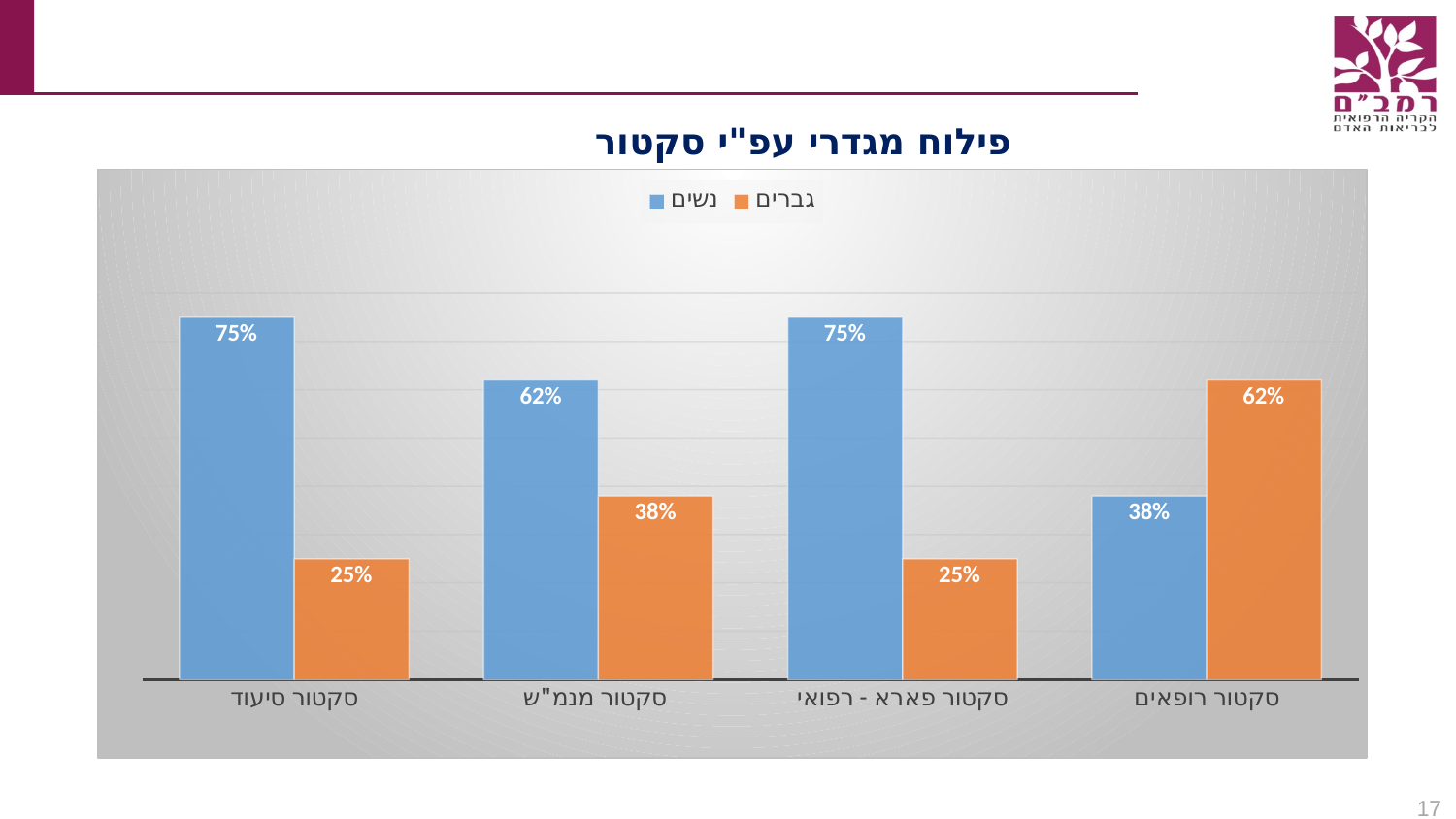
What is the value for נשים in סקטור סיעוד? 75% In which sector is the value for גברים the highest? סקטור רופאים How many series does the legend list? 2 How many sector categories are shown on the x axis? 4 What is the title of the chart? פילוח מגדרי עפ"י סקטור What is the difference between נשים and גברים in סקטור מנמ"ש? 24% Which is larger in סקטור רופאים, the value for נשים or the value for גברים? גברים What is the value for גברים in סקטור רופאים? 62% What is the value for נשים in סקטור פארא - רפואי? 75% What is the value for גברים in סקטור מנמ"ש? 38% What type of chart is shown on the slide? bar chart In which sector is the value for נשים the lowest? סקטור רופאים